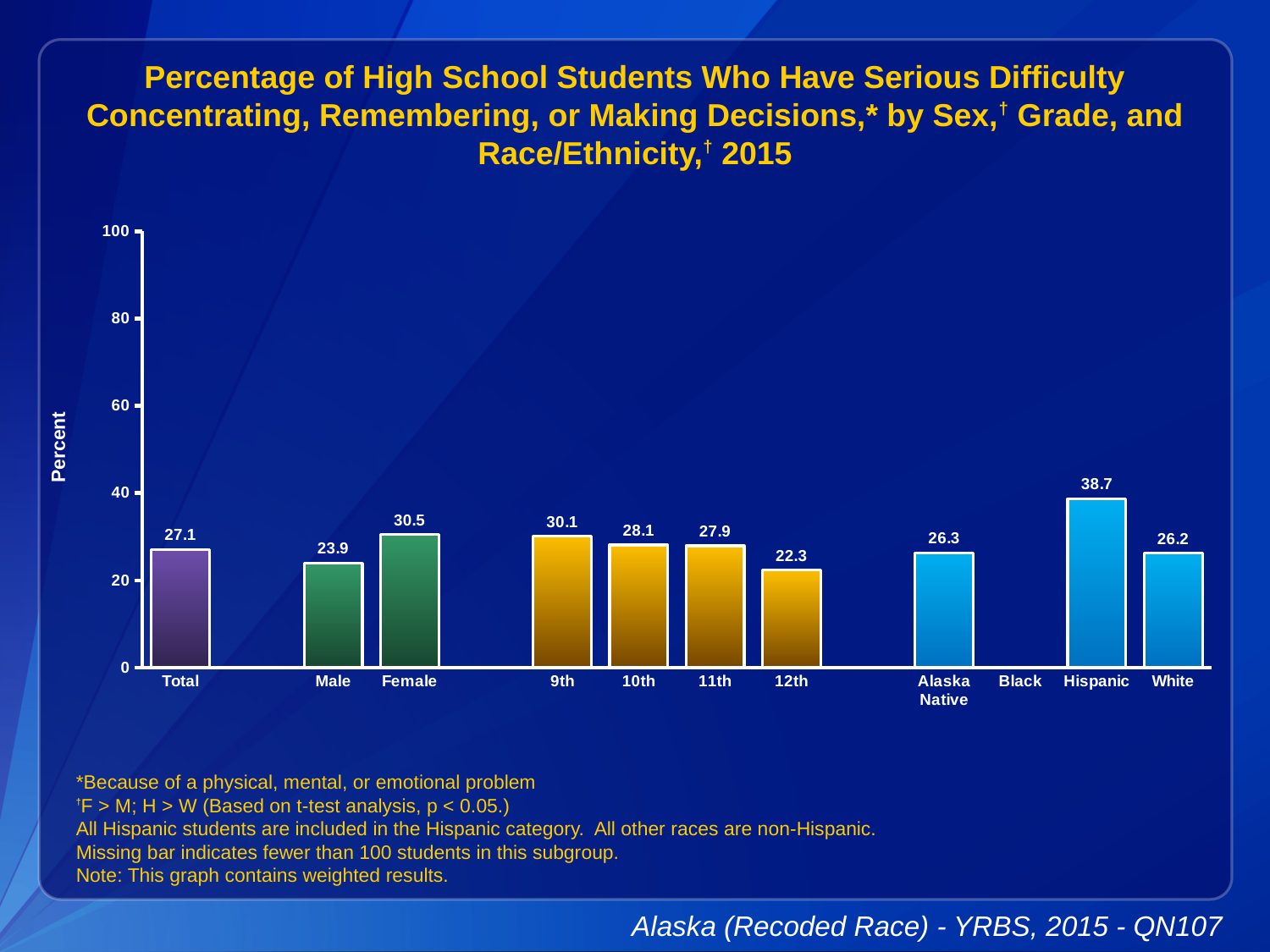
Is the value for Total greater or less than 40? less What is the value for 12th grade? 22.3 How many categories are labeled on the x axis? 11 Which category has the highest value? Hispanic Do the values rise or fall from 9th grade to 12th grade? fall Which category has the lowest value among those with a bar? 12th What is the difference between the Female and Male values? 6.6 What is the value for Female? 30.5 What kind of chart is shown? bar chart What is the value for Hispanic? 38.7 Which is larger, the value for 9th grade or the value for 10th grade? 9th Which category has no bar shown? Black